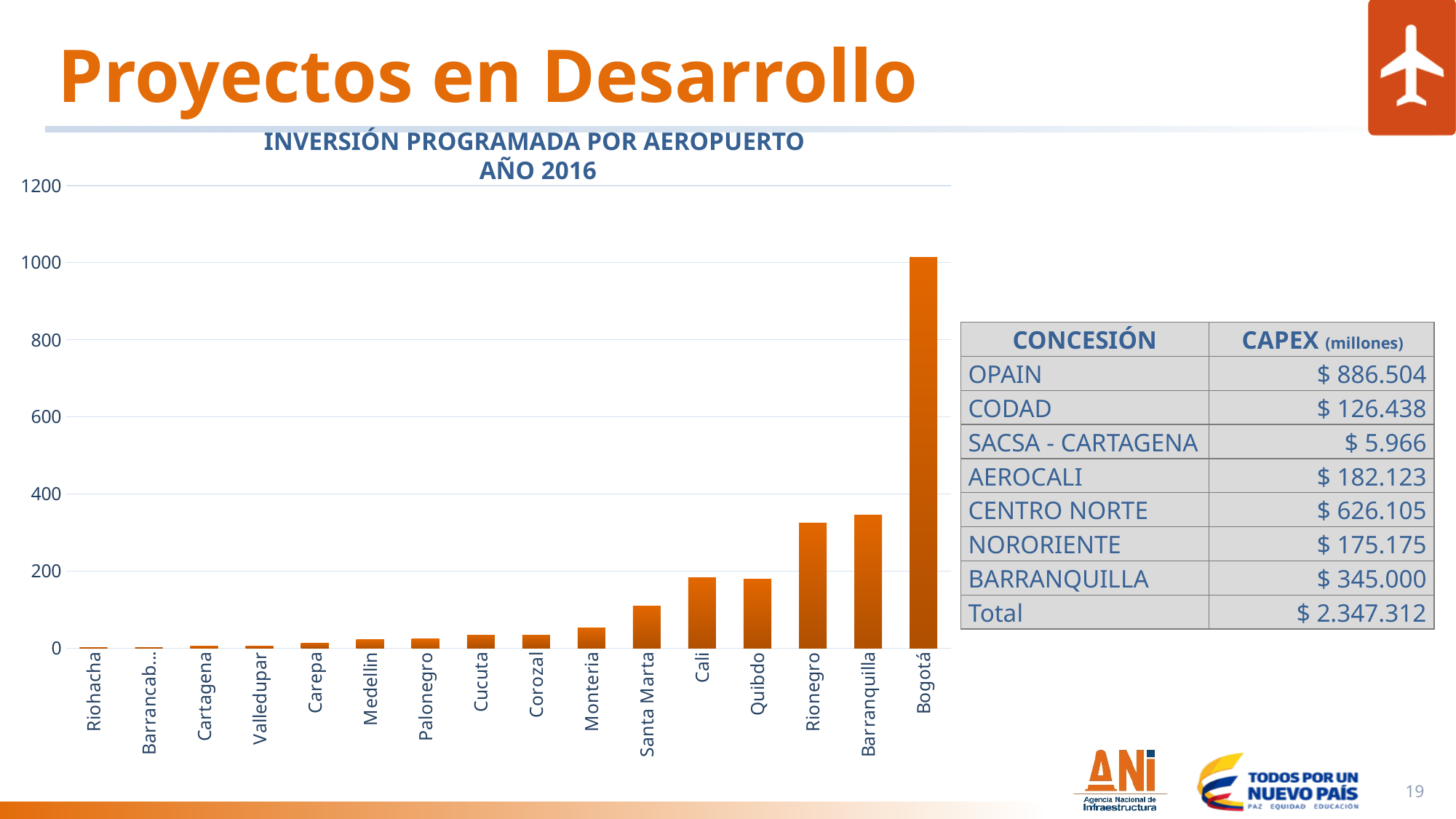
Which has a larger value, Monteria or Santa Marta? Santa Marta How many airports are shown on the x axis of the chart? 16 Is the value for Bogotá greater or less than 800? greater Is the value for Barranquilla greater or less than 400? less Which has a larger value, Bogotá or Barranquilla? Bogotá What is the title of the chart? INVERSIÓN PROGRAMADA POR AEROPUERTO AÑO 2016 Which airport has the highest programmed investment in the chart? Bogotá What kind of chart is shown on the slide? bar chart Is the value for Santa Marta greater or less than 200? less Do the bar values rise or fall from left to right along the x axis? rise